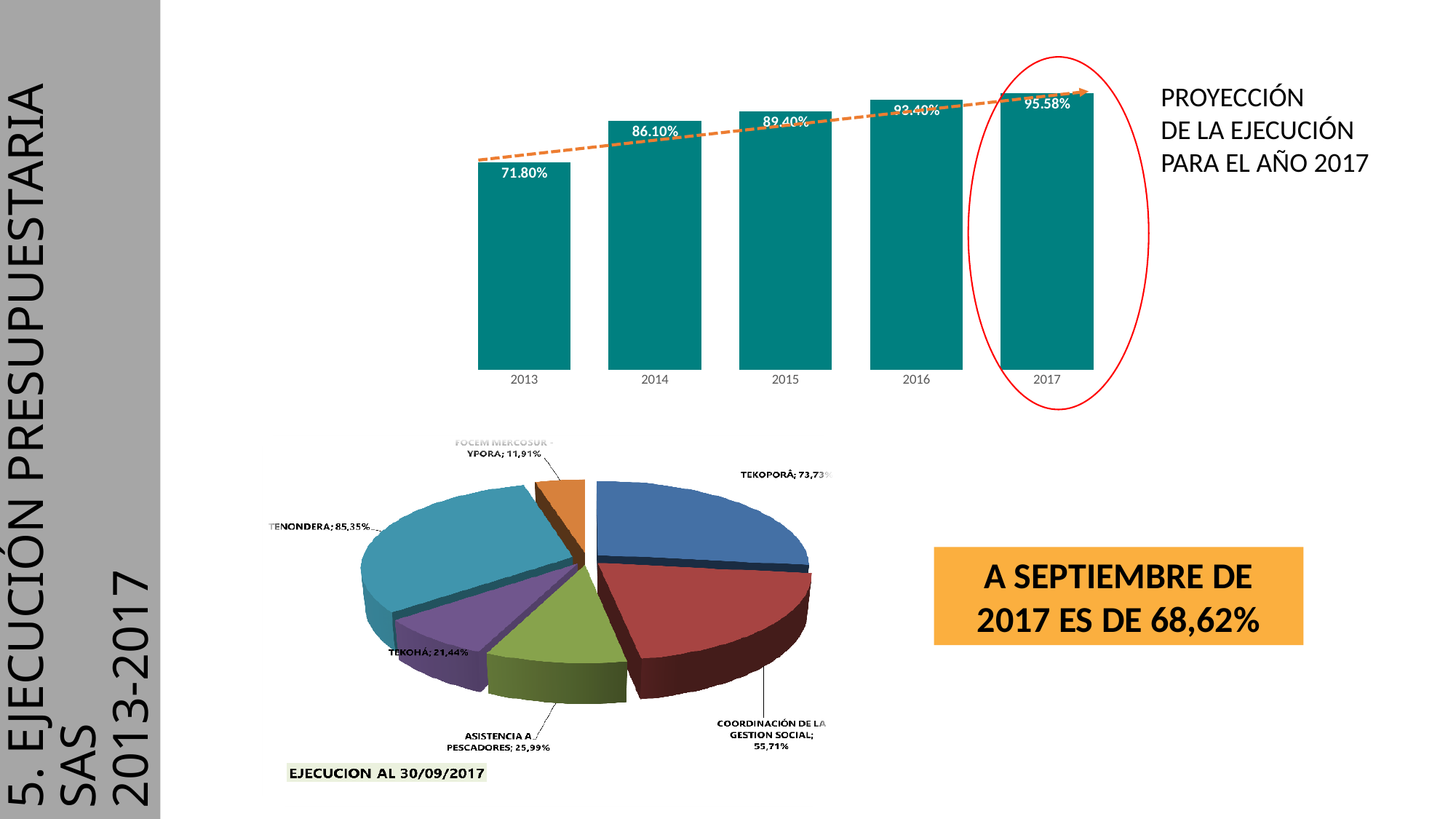
How many slices does the bottom pie chart (EJECUCION AL 30/09/2017) have? 6 In the bottom pie chart (EJECUCION AL 30/09/2017), what value is shown for TEKOHÁ? 21,44% In the bottom pie chart (EJECUCION AL 30/09/2017), what value is shown for TENONDERA? 85,35% What kind of chart is the bottom chart on the slide? pie chart In the top bar chart, what is the value shown for 2013? 71.80% In the top bar chart, what is the value shown for 2017? 95.58% In the top bar chart, what is the value shown for 2014? 86.10% How many years are shown in the top bar chart? 5 In the top bar chart, what is the difference between the 2017 value and the 2013 value? 23.78 percentage points In the top bar chart, do the values rise or fall from 2013 to 2017? rise In the top bar chart, which year has the lowest value? 2013 In the top bar chart, which year has the highest value? 2017